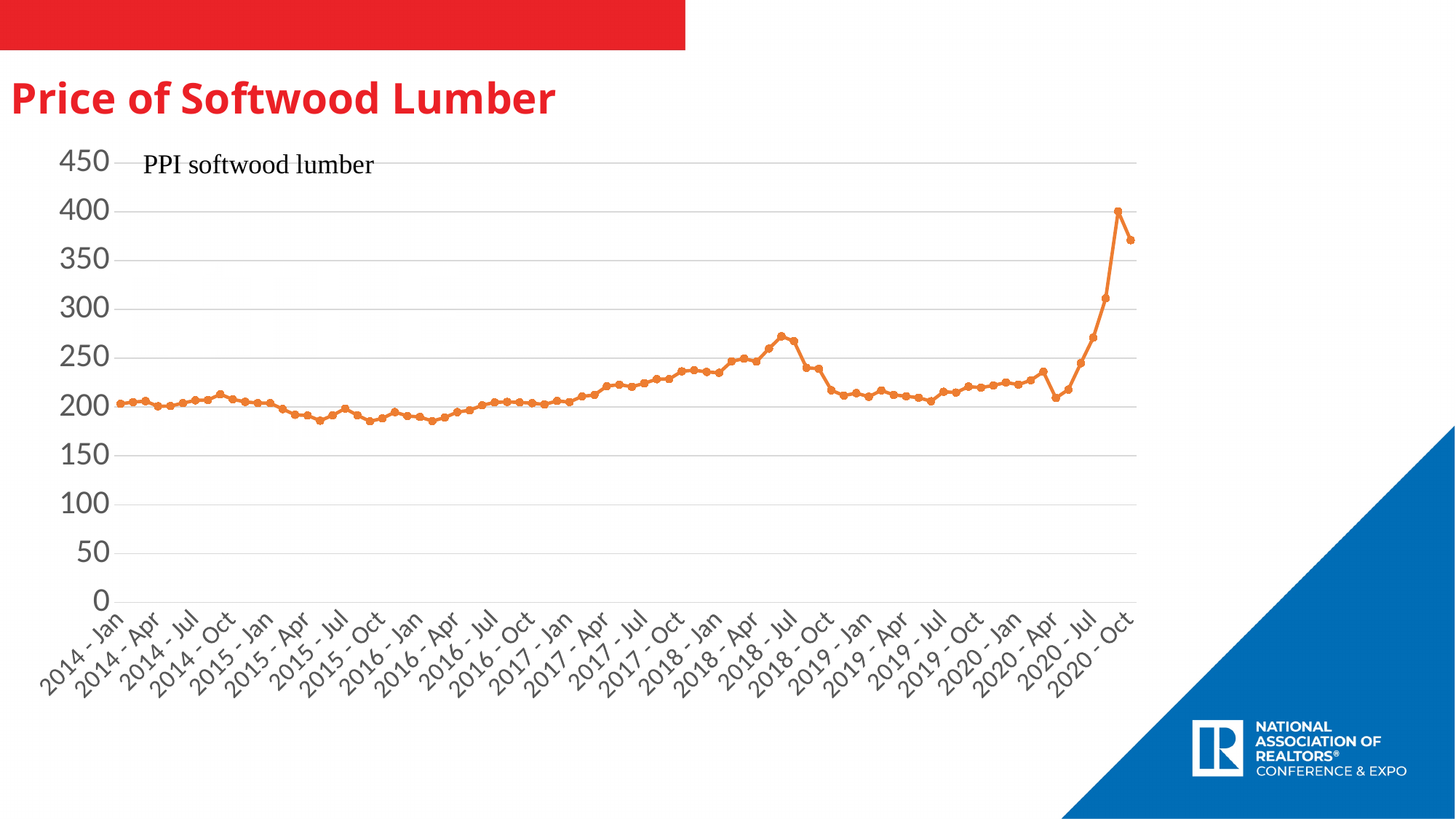
Is the value for 2015 - Oct greater or less than 200? less Is the value for 2020 - Oct greater or less than 350? greater What kind of chart is shown on the slide? line chart Is the value for 2018 - Jul greater or less than 250? greater Does the series rise or fall between 2020 - Apr and 2020 - Oct? rise In which year does the PPI softwood lumber series reach its highest value? 2020 What is the name of the series plotted on the chart? PPI softwood lumber What is the title of the slide's chart? Price of Softwood Lumber Which is larger, the value for 2018 - Jul or the value for 2019 - Jul? 2018 - Jul How many years are labelled on the x axis? 7 Which is larger, the value for 2014 - Jan or the value for 2020 - Oct? 2020 - Oct